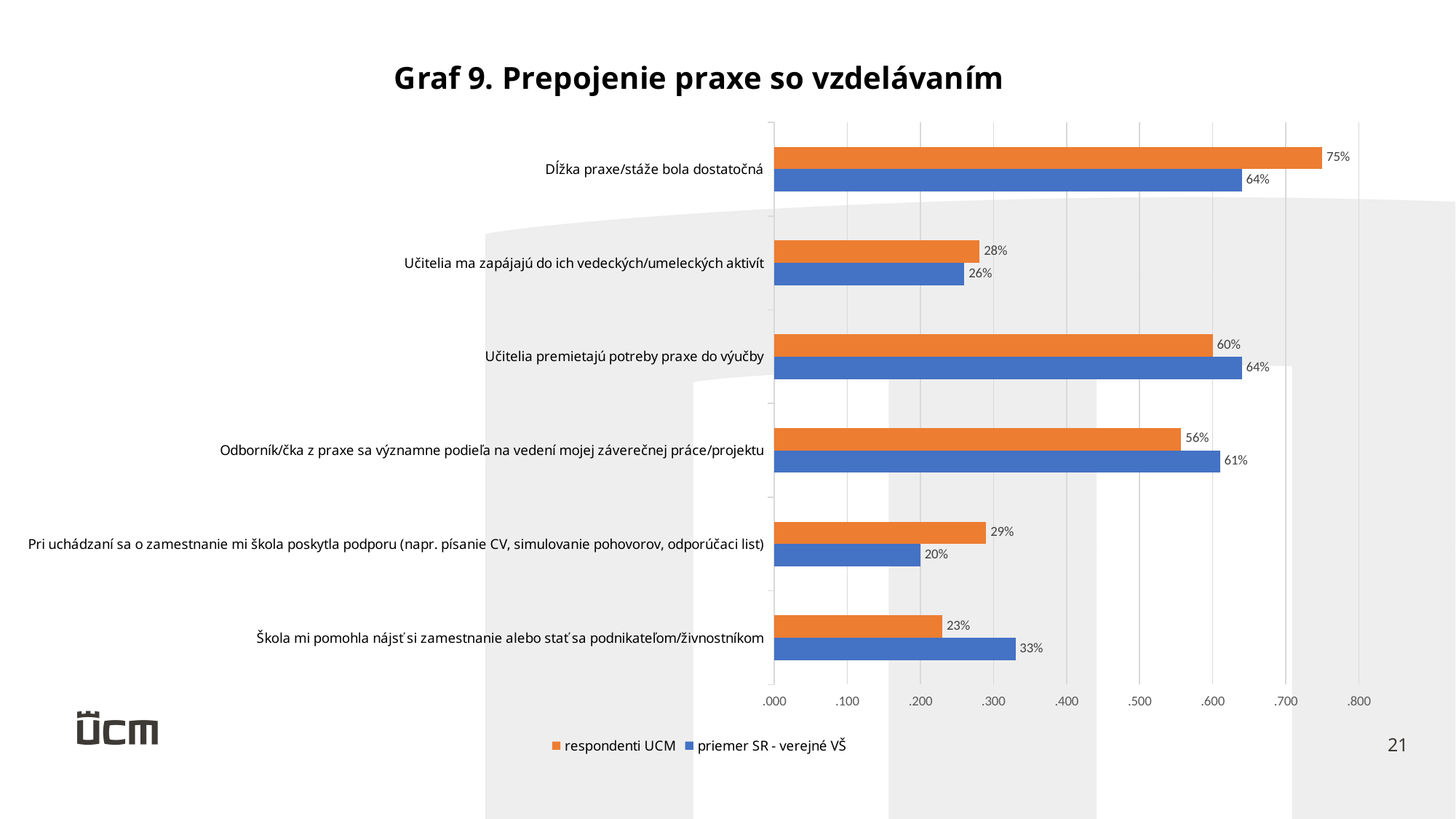
How many series does the legend list? 2 What is the title of the chart? Graf 9. Prepojenie praxe so vzdelávaním For "Učitelia premietajú potreby praxe do výučby", which series has the larger value? priemer SR - verejné VŠ Is the value for "respondenti UCM" for "Odborník/čka z praxe sa významne podieľa na vedení mojej záverečnej práce/projektu" greater or less than .500? greater What is the value for "priemer SR - verejné VŠ" for "Škola mi pomohla nájsť si zamestnanie alebo stať sa podnikateľom/živnostníkom"? 33% What is the value for "priemer SR - verejné VŠ" for "Pri uchádzaní sa o zamestnanie mi škola poskytla podporu"? 20% How many categories are shown on the chart? 6 Which category has the lowest value for "respondenti UCM"? Škola mi pomohla nájsť si zamestnanie alebo stať sa podnikateľom/živnostníkom What is the difference between "respondenti UCM" and "priemer SR - verejné VŠ" for "Dĺžka praxe/stáže bola dostatočná"? 11% Which category has the highest value for "respondenti UCM"? Dĺžka praxe/stáže bola dostatočná What kind of chart is shown on the slide? Bar chart What is the value for "respondenti UCM" for "Dĺžka praxe/stáže bola dostatočná"? 75%